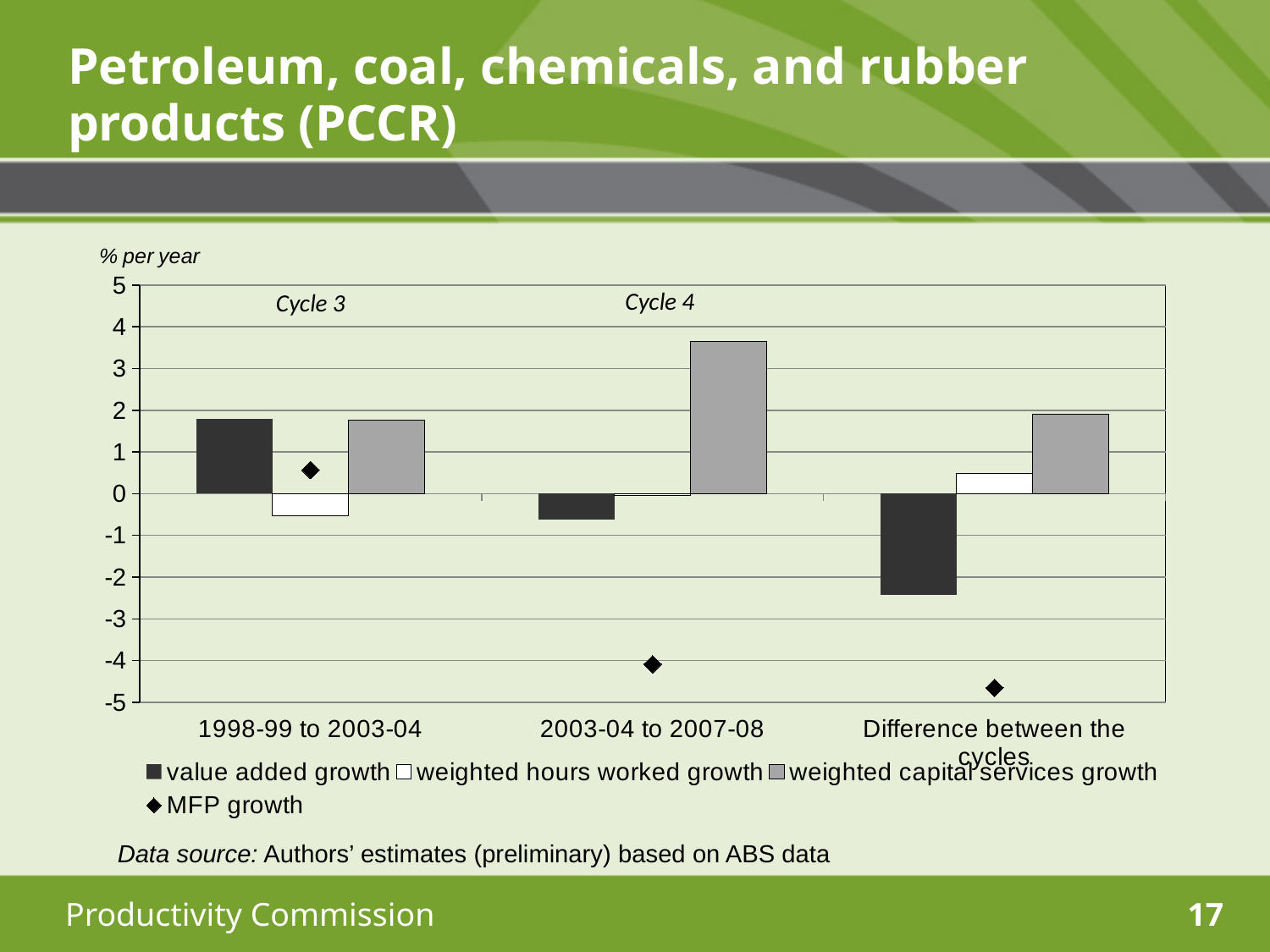
Is the value for weighted hours worked growth in 1998-99 to 2003-04 greater or less than 0? less Is the value for value added growth in the Difference between the cycles greater or less than -2? less What unit label is shown above the y axis? % per year Is the value for value added growth in 1998-99 to 2003-04 greater or less than 1? greater How many categories are shown on the x axis? 3 How many series does the legend list? 4 In which category is weighted capital services growth highest? 2003-04 to 2007-08 In which category is MFP growth lowest? Difference between the cycles Which period has the higher weighted capital services growth, 1998-99 to 2003-04 or 2003-04 to 2007-08? 2003-04 to 2007-08 What kind of chart is shown on the slide? bar chart